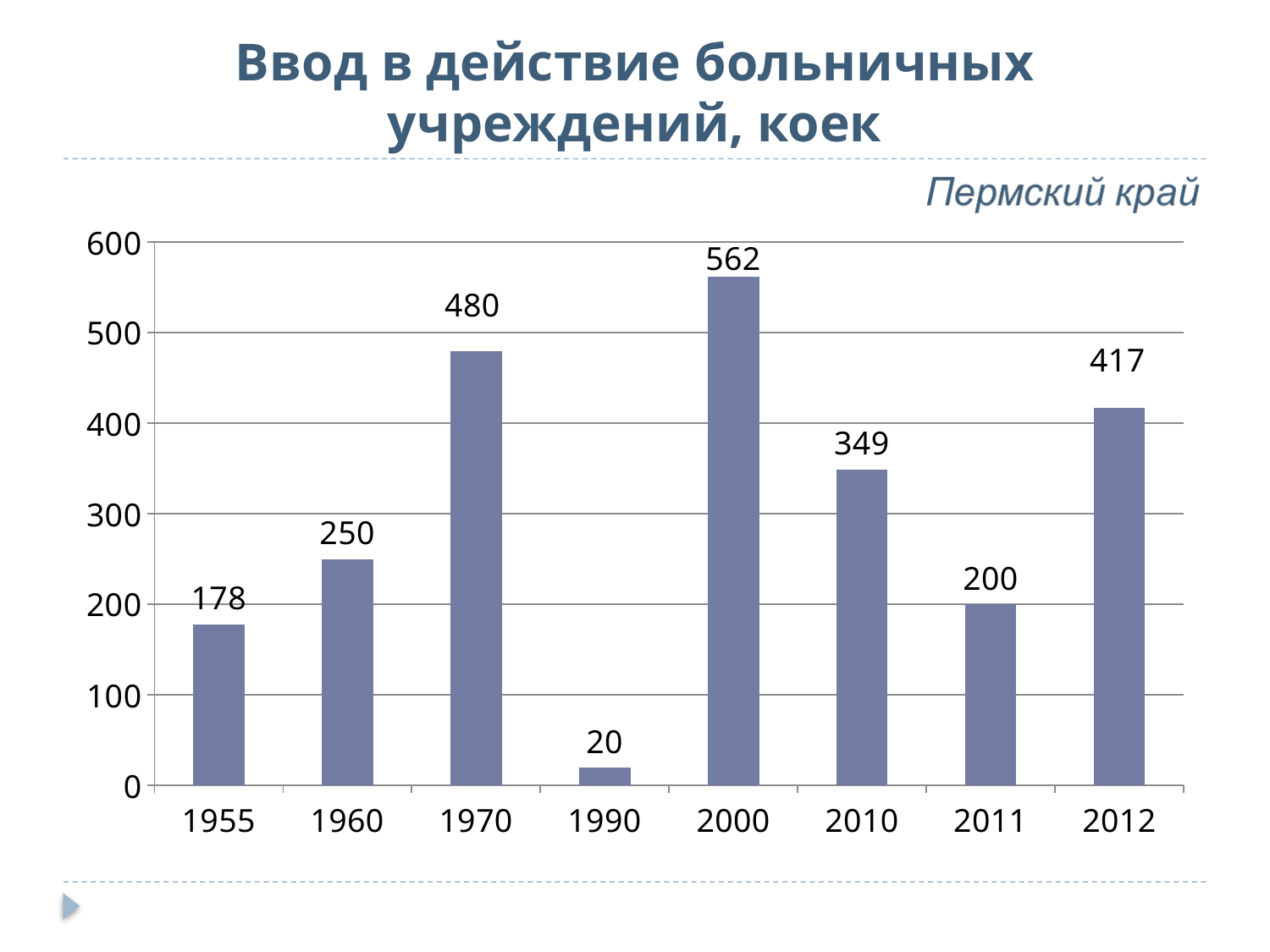
What is the difference between the values for 2000 and 2010? 213 What is the value for 1990? 20 How many years are shown on the x axis? 8 What region is named in the subtitle above the chart? Пермский край What is the value for 2012? 417 Which year has the highest value? 2000 Which is larger, the value for 2011 or the value for 2012? 2012 Which year has the lowest value? 1990 What kind of chart is shown on the slide? bar chart What is the difference between the values for 1960 and 1955? 72 Is the value for 2010 greater or less than 300? greater What is the value for 1970? 480